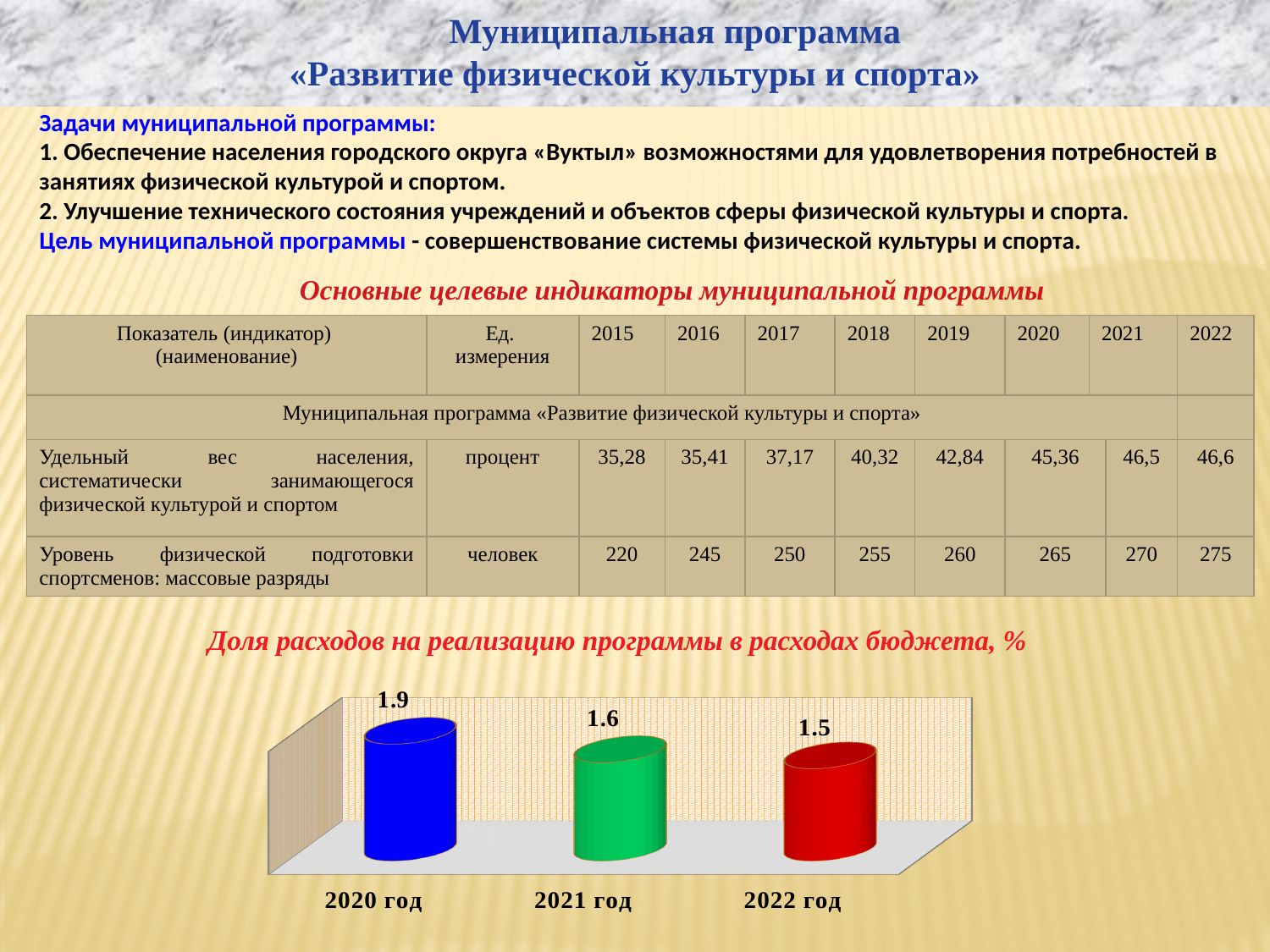
What is the value shown for 2022 год in the chart? 1.5 Which year has the lowest value in the chart? 2022 год What is the difference between the values for 2020 год and 2021 год? 0.3 Do the values rise or fall from 2020 год to 2022 год? fall Which year has the highest value in the chart? 2020 год What is the value shown for 2021 год in the chart? 1.6 What is the difference between the values for 2020 год and 2022 год? 0.4 What is the title of the chart? Доля расходов на реализацию программы в расходах бюджета, % Which is larger, the value for 2021 год or the value for 2022 год? 2021 год How many categories (years) are plotted in the chart? 3 What is the value shown for 2020 год in the chart? 1.9 What kind of chart is shown on the slide? bar chart